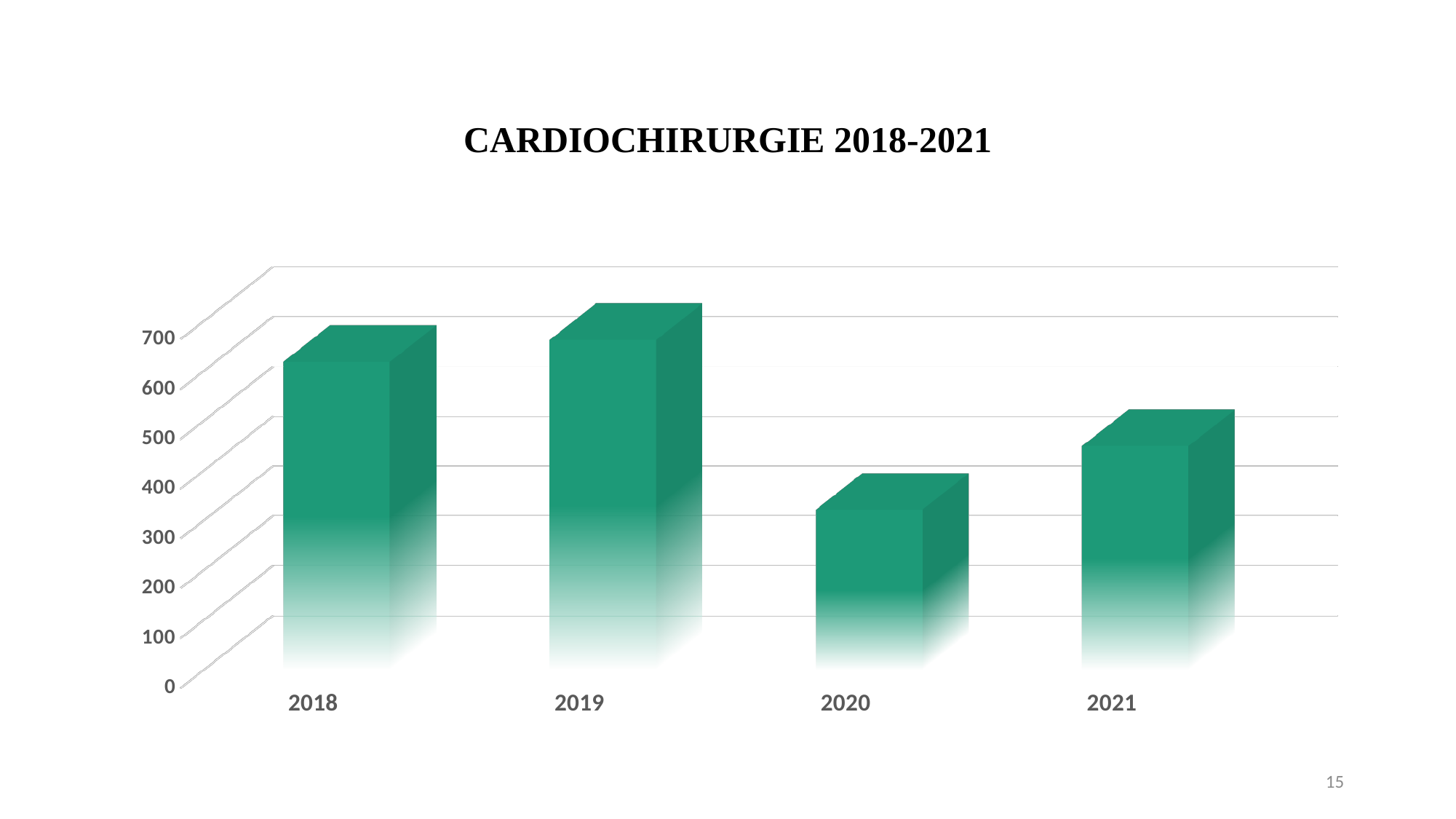
What colour are the bars in the chart? green Which year has the lowest bar? 2020 Which is larger, the value for 2020 or the value for 2021? 2021 Which year has the highest bar? 2019 Which is larger, the value for 2018 or the value for 2021? 2018 What is the title of the chart? CARDIOCHIRURGIE 2018-2021 Is the value for 2021 greater or less than 300? greater What kind of chart is shown on the slide? bar chart Is the value for 2020 greater or less than 500? less How many years (categories) are shown on the x axis? 4 Is the value for 2019 greater or less than 500? greater Does the value rise or fall from 2019 to 2020? fall